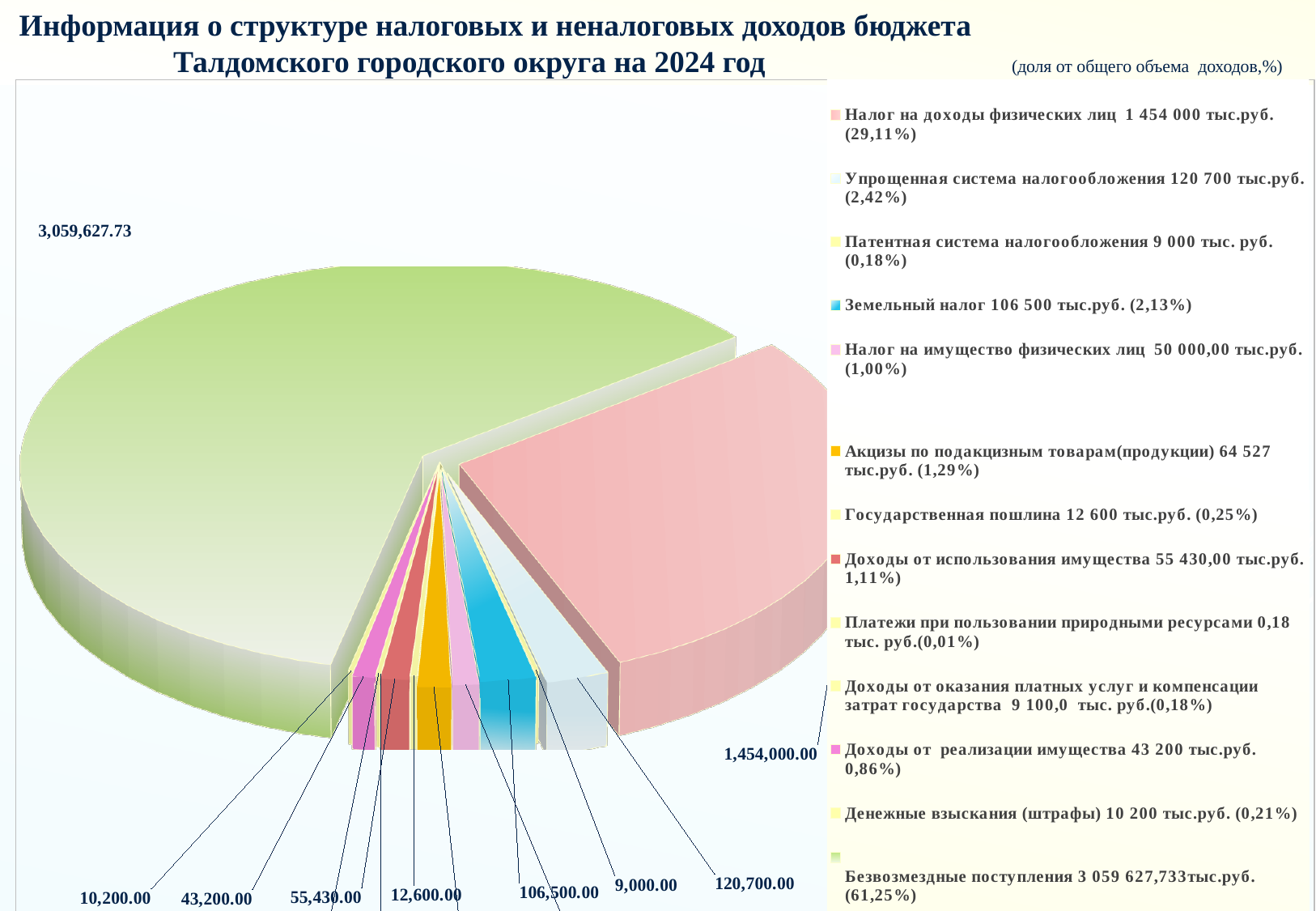
What kind of chart is shown on the slide? pie chart What year does the chart title refer to? 2024 Which category has the smallest share of the pie according to the legend? Платежи при пользовании природными ресурсами What is the data label value for Налог на доходы физических лиц? 1,454,000.00 Which is larger: Упрощенная система налогообложения or Земельный налог? Упрощенная система налогообложения How many categories does the legend list? 13 Which category has the largest slice of the pie? Безвозмездные поступления What share of total revenue does Налог на доходы физических лиц represent, as shown in the legend? 29,11% What is the data label value for Безвозмездные поступления? 3,059,627.73 What is the data label value for Государственная пошлина? 12,600.00 What share of total revenue does Безвозмездные поступления represent, as shown in the legend? 61,25% What is the difference between the values for Упрощенная система налогообложения (120,700.00) and Земельный налог (106,500.00)? 14,200.00